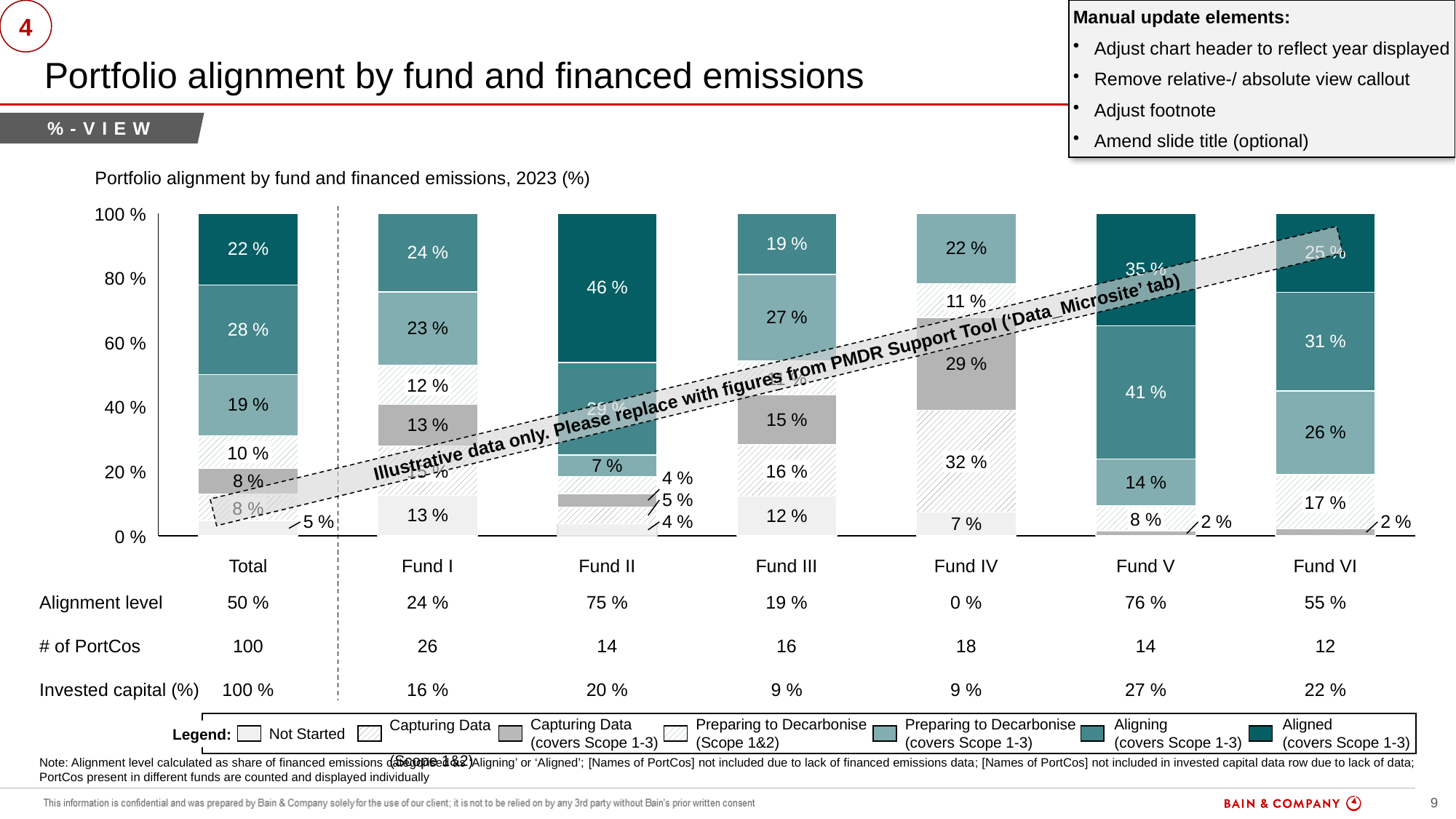
What is the title of the chart? Portfolio alignment by fund and financed emissions, 2023 (%) What is the 'Aligned (covers Scope 1-3)' share for Fund II? 46 % How many series does the chart legend list? 7 How many categories (bars) are shown along the x axis of the chart? 7 Which fund has the largest 'Aligned (covers Scope 1-3)' segment? Fund II What kind of chart is shown on the slide? Stacked bar chart What is the 'Capturing Data (Scope 1&2)' share for Fund IV? 32 % What is the 'Preparing to Decarbonise (covers Scope 1-3)' share for Fund VI? 26 % What is the 'Not Started' share for Fund I? 13 % Which has a larger 'Capturing Data (covers Scope 1-3)' share, Fund III or Fund IV? Fund IV What is the difference between the 'Aligning (covers Scope 1-3)' shares of Fund V and Fund VI? 10 percentage points What is the 'Aligning (covers Scope 1-3)' share for Fund V? 41 %